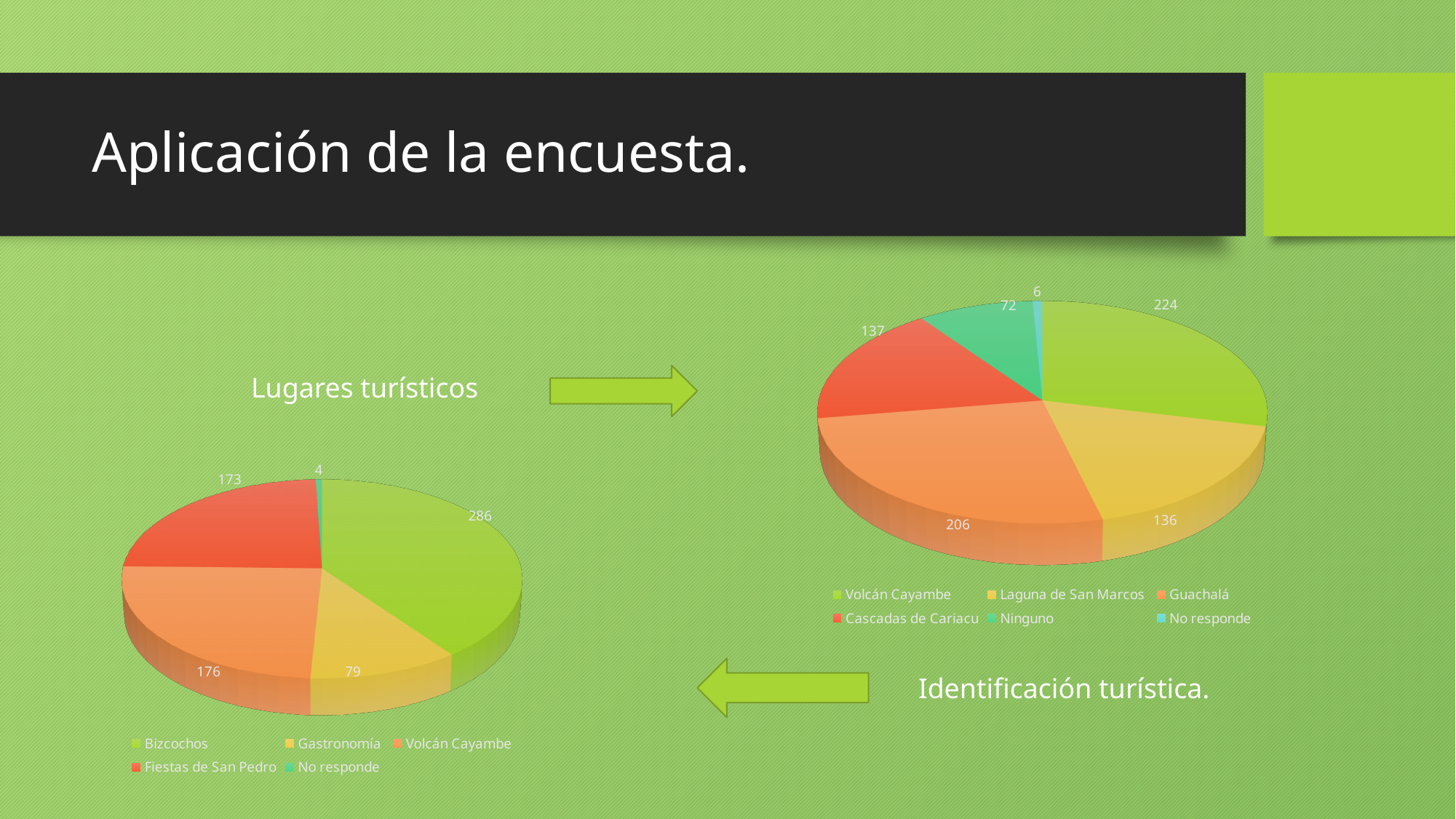
In the left pie chart (Lugares turísticos), which category has the smallest value? No responde In the left pie chart (Lugares turísticos), what is the value for Gastronomía? 79 In the right pie chart (Identificación turística), what is the value for Ninguno? 72 What type of chart is used for Lugares turísticos on the left? Pie chart In the right pie chart (Identificación turística), how many categories are shown? 6 In the left pie chart (Lugares turísticos), how many categories does the legend list? 5 In the left pie chart (Lugares turísticos), what is the difference between Volcán Cayambe and Fiestas de San Pedro? 3 In the right pie chart (Identificación turística), which is larger, Laguna de San Marcos or Cascadas de Cariacu? Cascadas de Cariacu In the right pie chart (Identificación turística), which category has the largest value? Volcán Cayambe In the left pie chart (Lugares turísticos), what is the value for Bizcochos? 286 In the right pie chart (Identificación turística), what is the difference between Volcán Cayambe and Guachalá? 18 In the right pie chart (Identificación turística), what is the value for Guachalá? 206